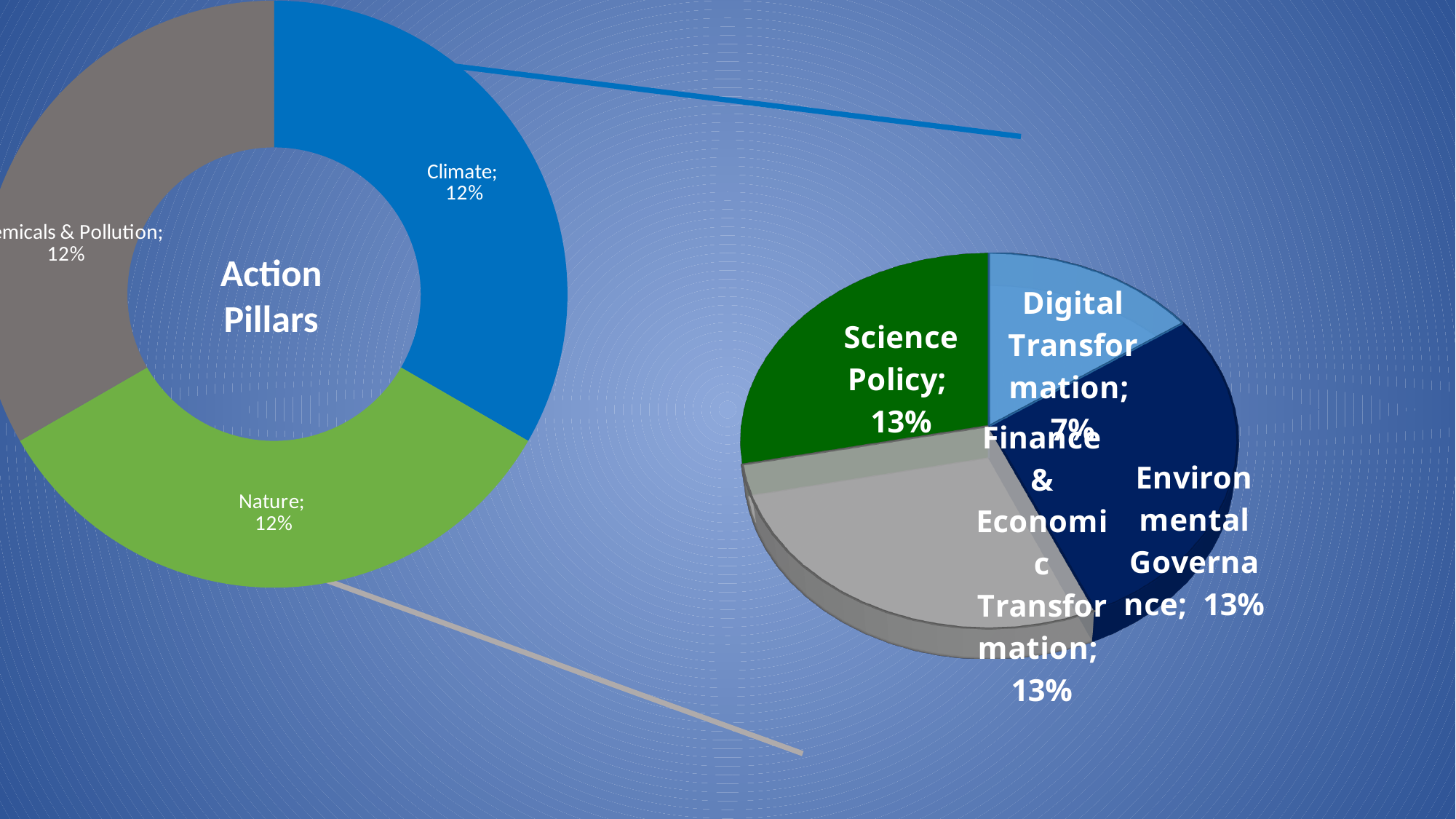
In the pie chart on the right, how many slices are shown? 4 In the pie chart on the right, what is the difference between Finance & Economic Transformation and Digital Transformation? 6 percentage points What title is shown in the centre of the doughnut chart on the left? Action Pillars In the pie chart on the right, which is larger: Science Policy or Digital Transformation? Science Policy What kind of chart is the chart on the right of the slide? Pie chart In the pie chart on the right, what is the value for Digital Transformation? 7% In the Action Pillars chart on the left, what is the value for Climate? 12% In the pie chart on the right, what is the value for Environmental Governance? 13% In the Action Pillars chart on the left, what is the value for Nature? 12% In the pie chart on the right, what is the value for Science Policy? 13% What kind of chart is the chart on the left of the slide? Doughnut chart In the pie chart on the right, which slice has the smallest value? Digital Transformation